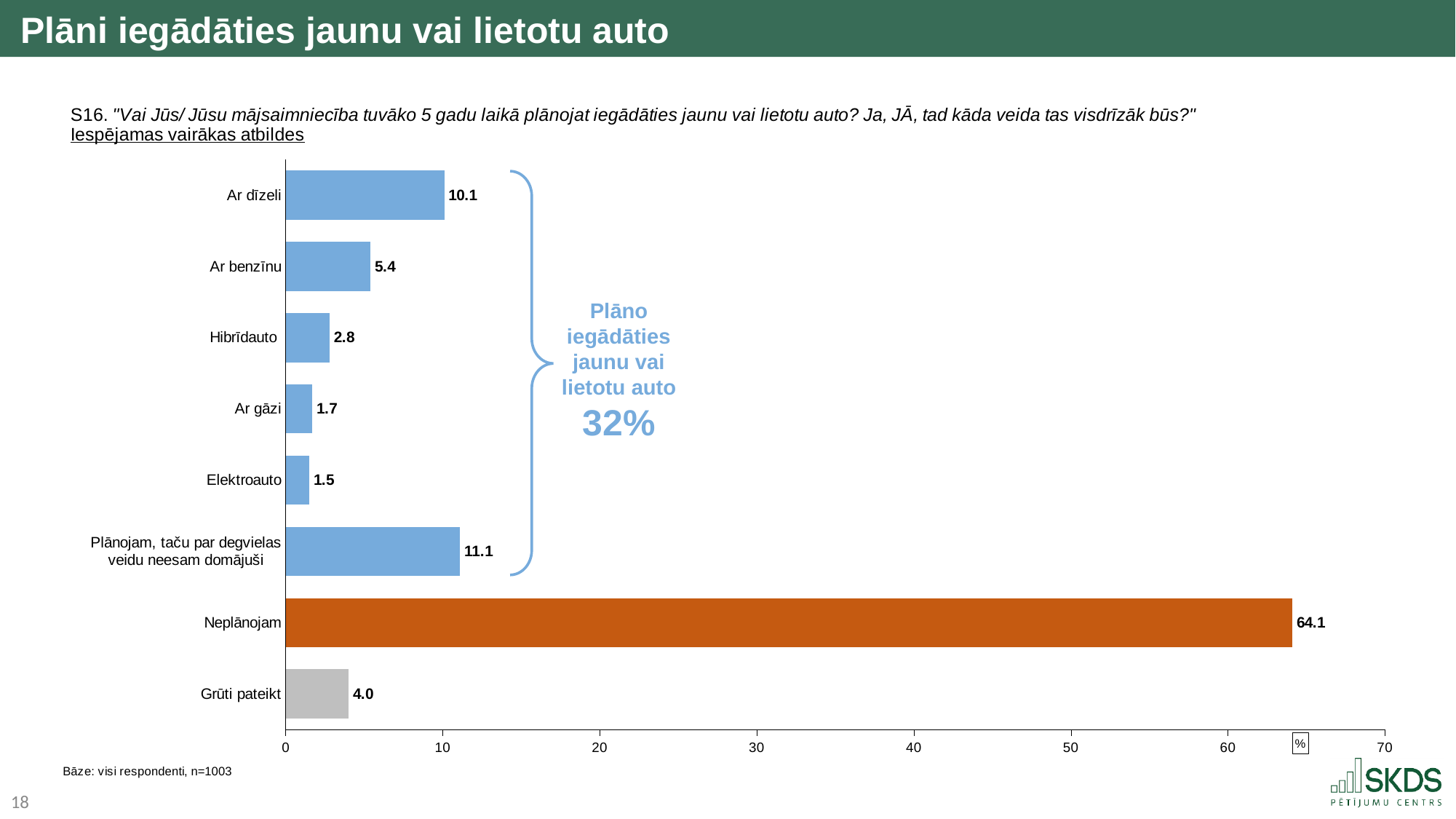
How many categories are shown in the chart? 8 What is the difference between the values for Ar dīzeli and Ar benzīnu? 4.7 What is the value for Neplānojam? 64.1 Is the value for Neplānojam greater or less than 60? greater What kind of chart is shown on the slide? bar chart Which is larger, the value for Hibrīdauto or the value for Ar gāzi? Hibrīdauto What is the value for Elektroauto? 1.5 Which category has the highest value? Neplānojam What percentage is shown next to the bracket labelled 'Plāno iegādāties jaunu vai lietotu auto'? 32% What is the value for Plānojam, taču par degvielas veidu neesam domājuši? 11.1 What is the value for Ar dīzeli? 10.1 Which category has the lowest value? Elektroauto